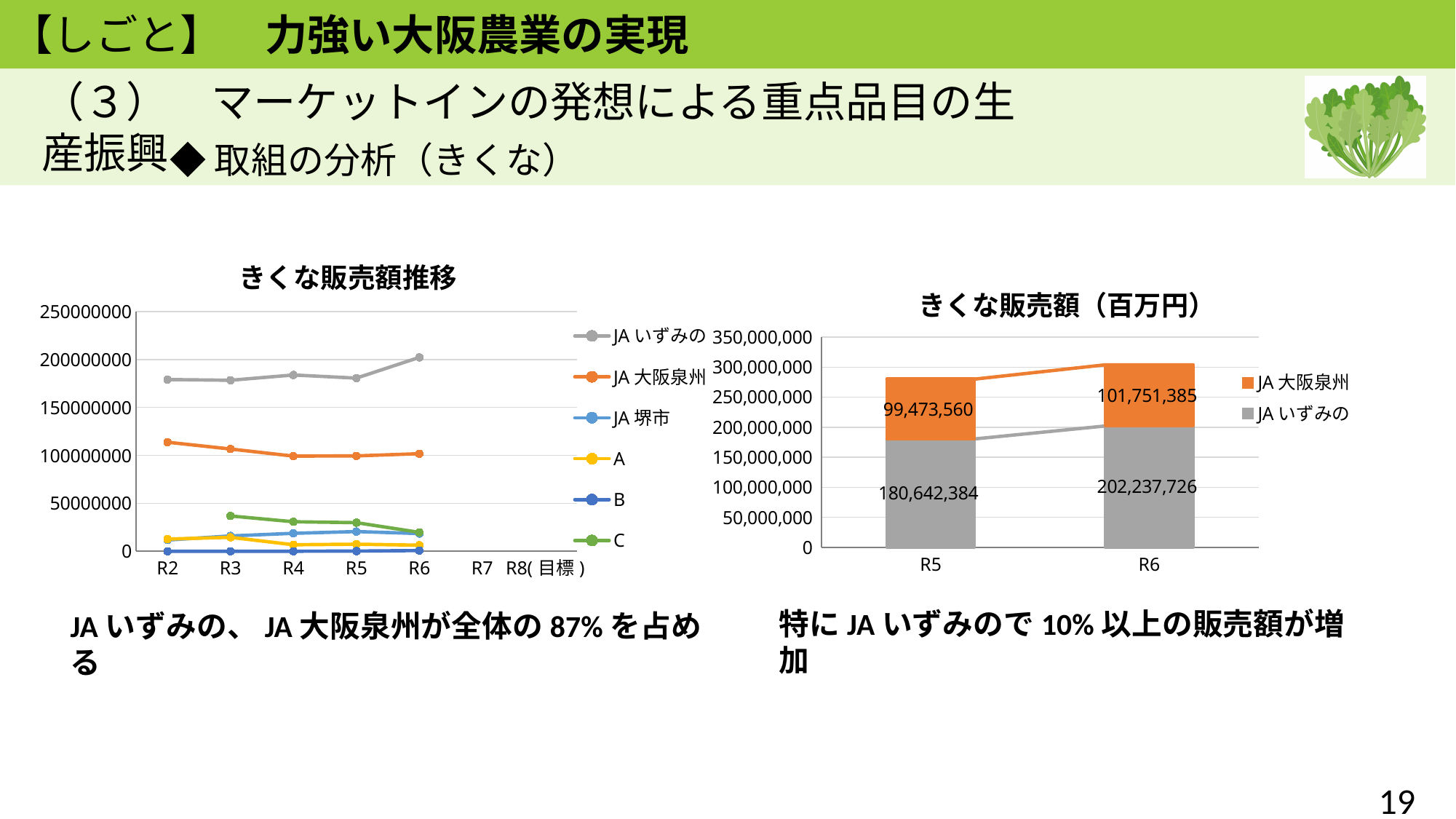
In the chart titled きくな販売額（百万円）, what is the value for JA 大阪泉州 in R6? 101,751,385 In the chart titled きくな販売額推移, which series has the highest value at R6? JA いずみの In the chart titled きくな販売額推移, is the value for JA 大阪泉州 at R2 greater or less than 100000000? greater What kind of chart is the chart titled きくな販売額（百万円）? stacked bar chart In the chart titled きくな販売額（百万円）, how many categories are shown on the x axis? 2 In the chart titled きくな販売額推移, is the value for JA いずみの at R2 greater or less than 200000000? less In the chart titled きくな販売額（百万円）, what is the value for JA いずみの in R5? 180,642,384 In the chart titled きくな販売額（百万円）, what is the difference between the JA いずみの values for R6 and R5? 21,595,342 What kind of chart is the chart titled きくな販売額推移? line chart In the chart titled きくな販売額（百万円）, what is the total of the stacked bar for R6? 303,989,111 In the chart titled きくな販売額推移, which is larger at R3: JA 大阪泉州 or JA 堺市? JA 大阪泉州 How many series does the legend of the chart titled きくな販売額推移 list? 6